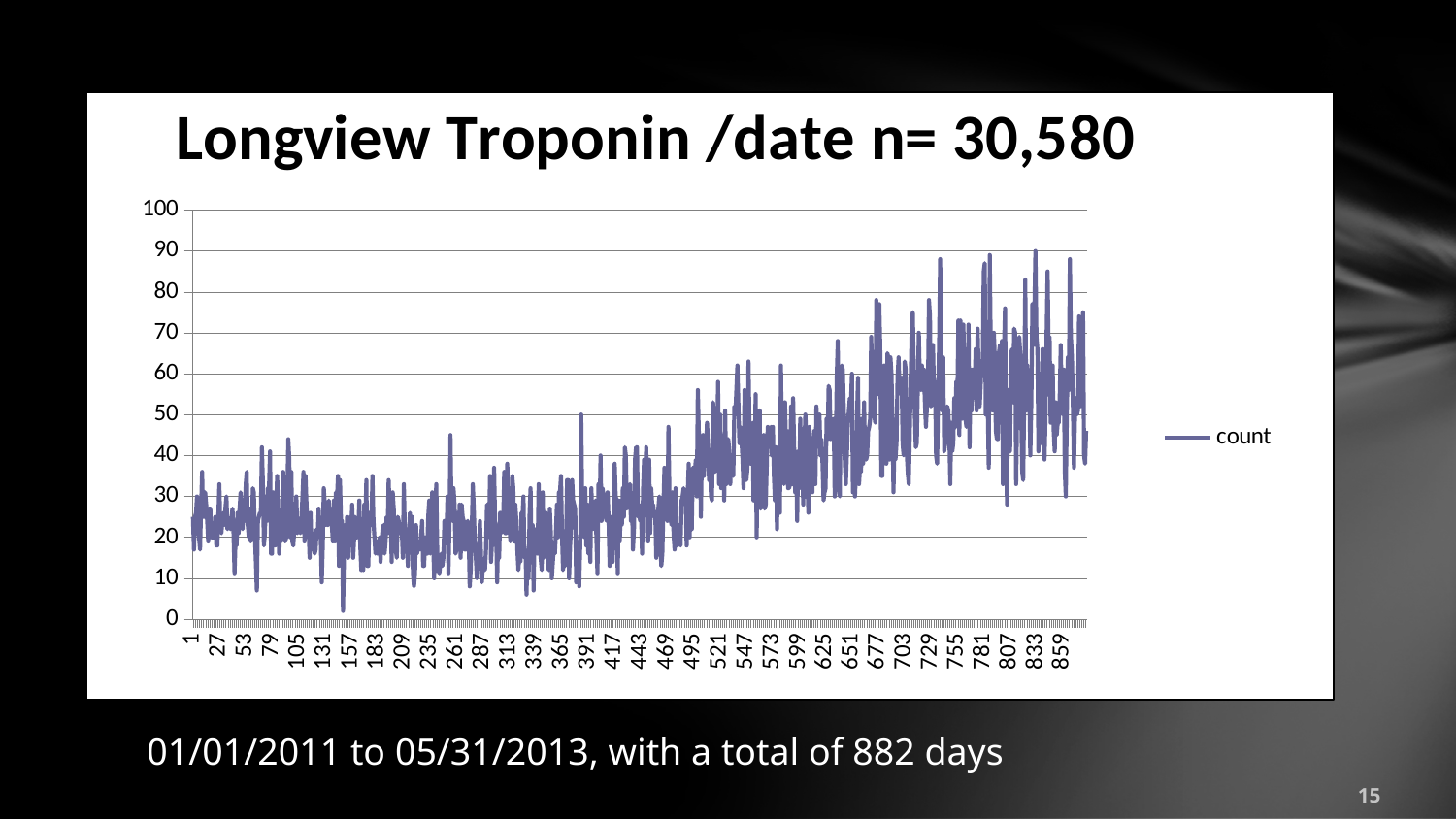
Is the value for category 27 greater or less than 60? less Is the value for category 859 greater or less than 30? greater How many series does the legend list? 1 What is the title of the chart? Longview Troponin /date n= 30,580 Overall, do the values rise or fall as you move from left to right along the x axis? rise Is the highest value plotted on the chart greater or less than 80? greater What kind of chart is shown on the slide? line chart Are the values in the right half of the chart (after category 495) generally higher or lower than those in the left half? higher What is the name of the series shown in the legend? count What is the highest tick value shown on the y axis? 100